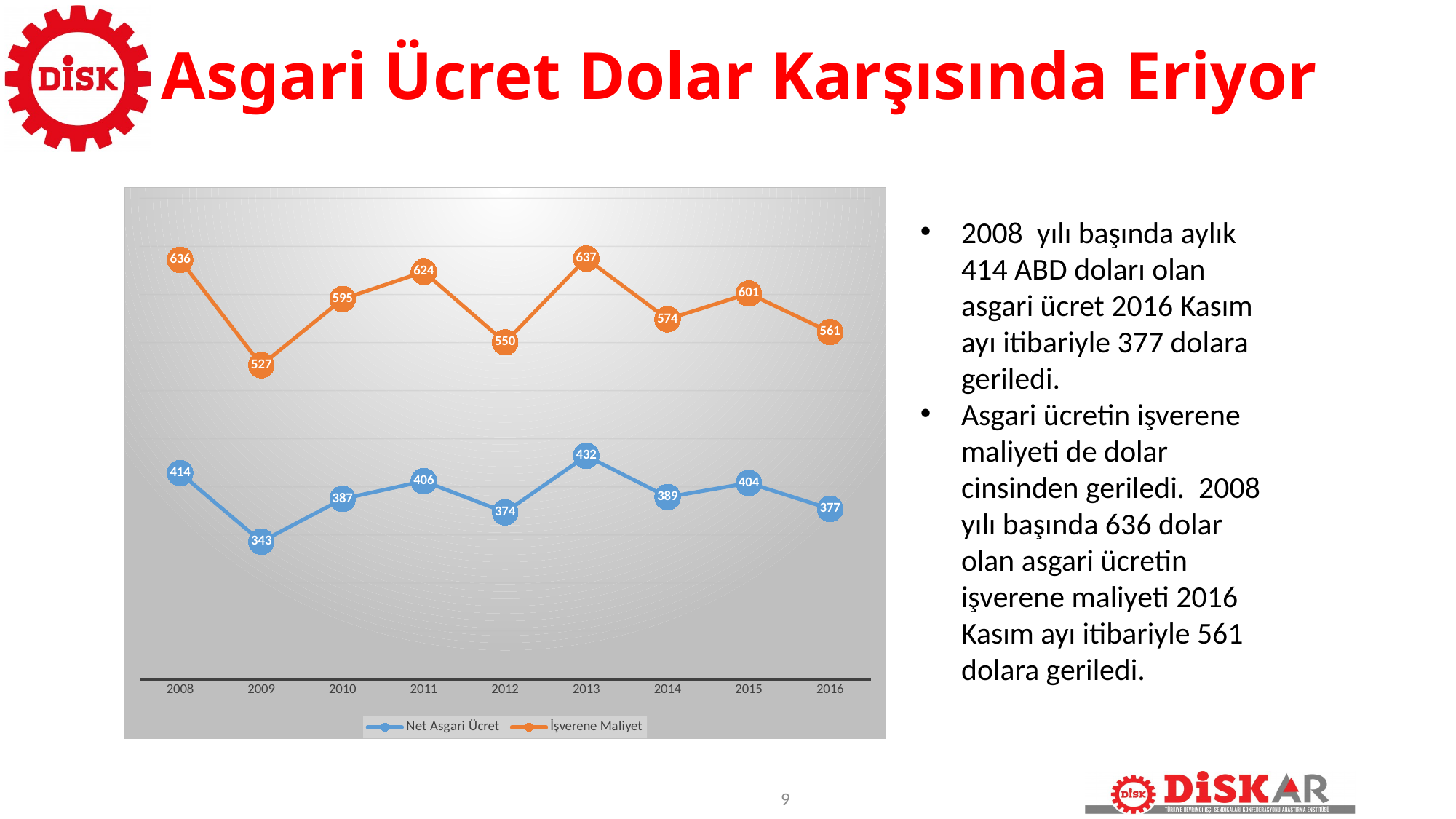
Which is larger, Net Asgari Ücret in 2011 or in 2015? 2011 What kind of chart is shown on the slide? line chart What is the value of Net Asgari Ücret in 2008? 414 Which colour represents İşverene Maliyet in the chart? orange How many series does the legend list? 2 In which year is İşverene Maliyet lowest? 2009 What is the value of İşverene Maliyet in 2012? 550 In which year is Net Asgari Ücret highest? 2013 What is the value of İşverene Maliyet in 2016? 561 What is the difference between Net Asgari Ücret in 2008 and in 2016? 37 What is the difference between İşverene Maliyet and Net Asgari Ücret in 2016? 184 How many years are shown on the x axis? 9